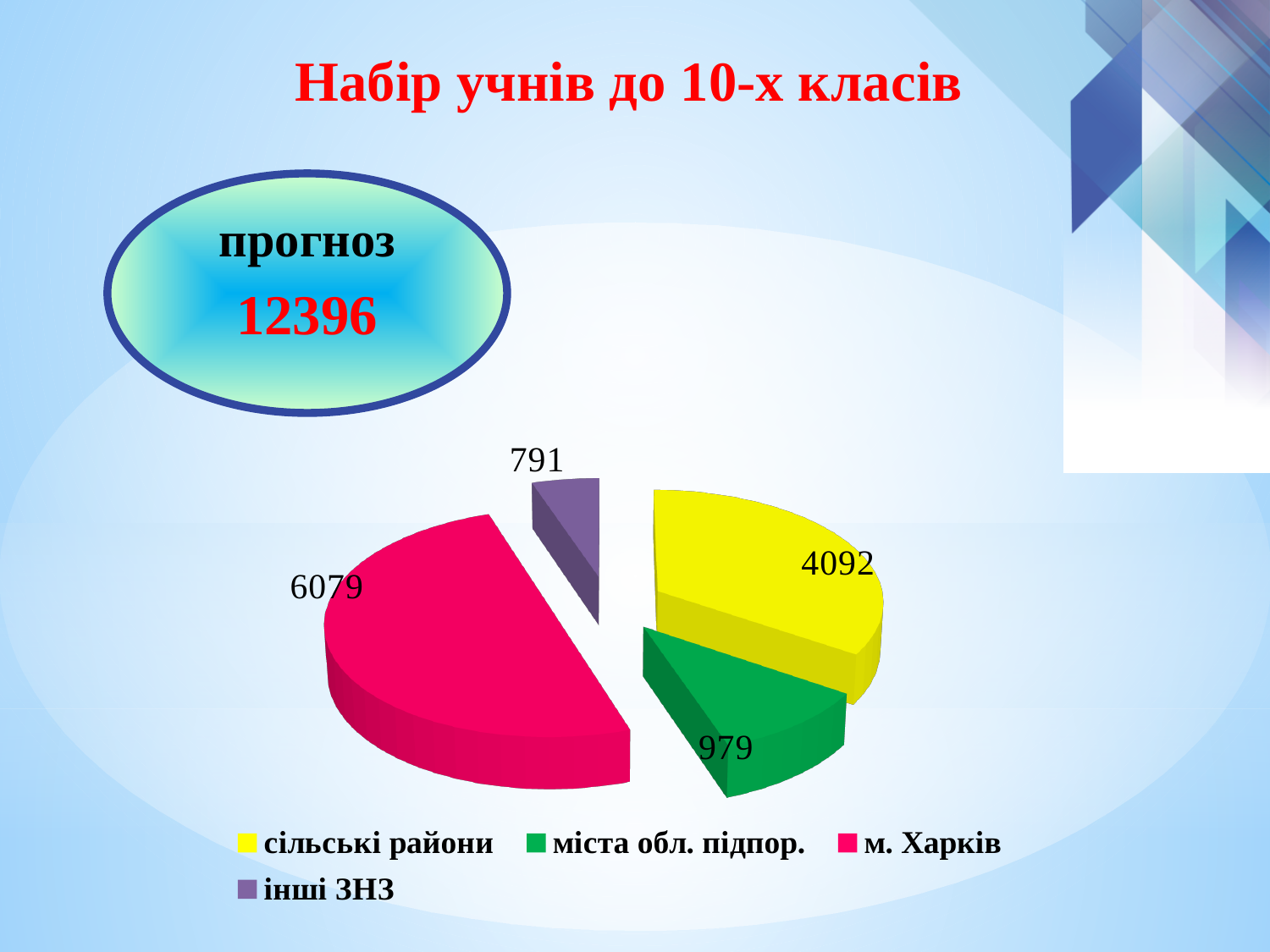
What is the value for міста обл. підпор. in the pie chart? 979 How many categories does the pie chart have? 4 What colour is the slice for м. Харків? pink (red) What is the difference between the values for міста обл. підпор. and інші ЗНЗ? 188 What is the value for сільські райони in the pie chart? 4092 What type of chart is shown on the slide? pie chart What is the value for м. Харків in the pie chart? 6079 What is the difference between the values for м. Харків and сільські райони? 1987 What is the value for інші ЗНЗ in the pie chart? 791 Which category has the largest slice in the pie chart? м. Харків Which is larger, the value for сільські райони or the value for міста обл. підпор.? сільські райони Which category has the smallest slice in the pie chart? інші ЗНЗ